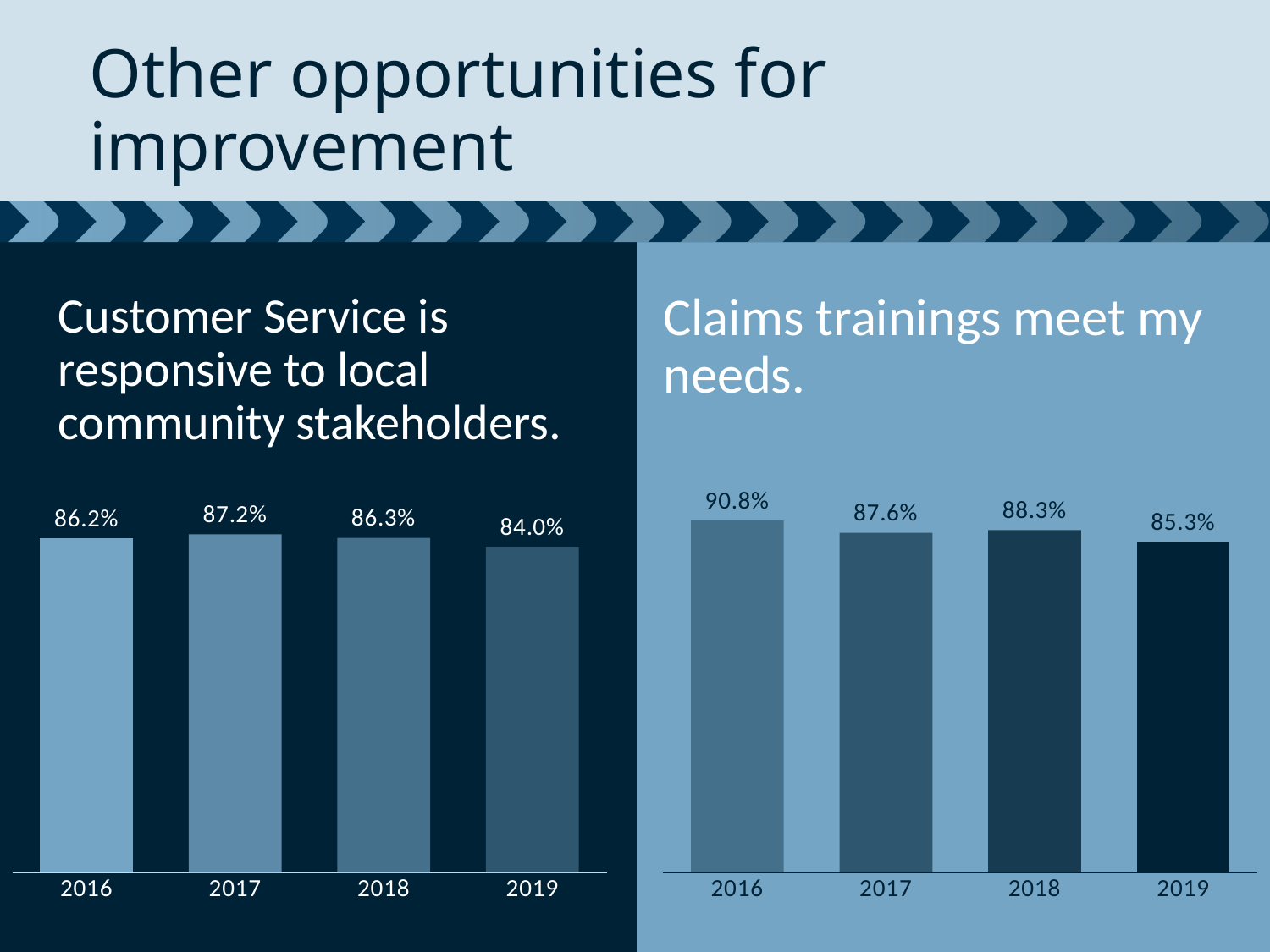
In the left chart (Customer Service is responsive to local community stakeholders), what is the difference between the 2017 and 2019 values? 3.2% In the left chart (Customer Service is responsive to local community stakeholders), which year has the highest value? 2017 In the left chart (Customer Service is responsive to local community stakeholders), what is the value for 2019? 84.0% In the right chart (Claims trainings meet my needs), what is the difference between the 2016 and 2019 values? 5.5% In the right chart (Claims trainings meet my needs), what is the value for 2016? 90.8% In the right chart (Claims trainings meet my needs), which is larger, the value for 2017 or the value for 2018? 2018 In the right chart (Claims trainings meet my needs), what is the value for 2018? 88.3% In the left chart (Customer Service is responsive to local community stakeholders), what is the value for 2017? 87.2% In the left chart (Customer Service is responsive to local community stakeholders), which year has the lowest value? 2019 What kind of chart is the right chart (Claims trainings meet my needs)? Bar chart How many years are shown in the left chart (Customer Service is responsive to local community stakeholders)? 4 In the right chart (Claims trainings meet my needs), which year has the highest value? 2016